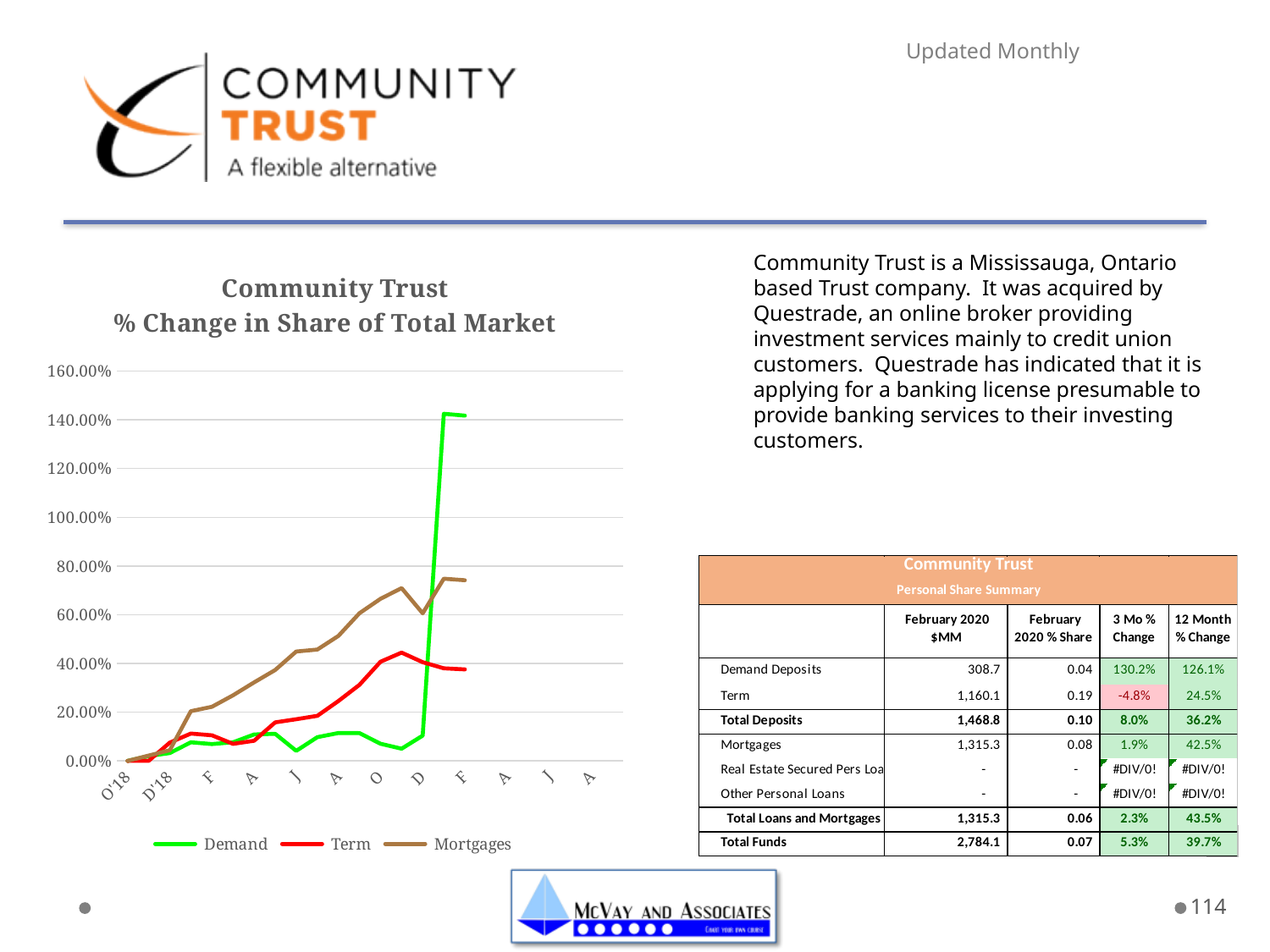
What kind of chart is shown on the slide? line chart Is the final plotted value of the Term series greater or less than 60.00%? less Is the final plotted value of the Mortgages series greater or less than 60.00%? greater How many category labels are shown along the x axis of the chart? 12 Is the final plotted value of the Demand series greater or less than 120.00%? greater What is the title of the chart? Community Trust % Change in Share of Total Market At the last plotted point, which series has the larger value, Demand or Term? Demand Which series reaches the highest value anywhere on the chart? Demand How many series does the chart's legend list? 3 Does the Mortgages line generally rise or fall from O'18 to its last plotted point? rise What are the three series named in the chart's legend? Demand, Term, Mortgages